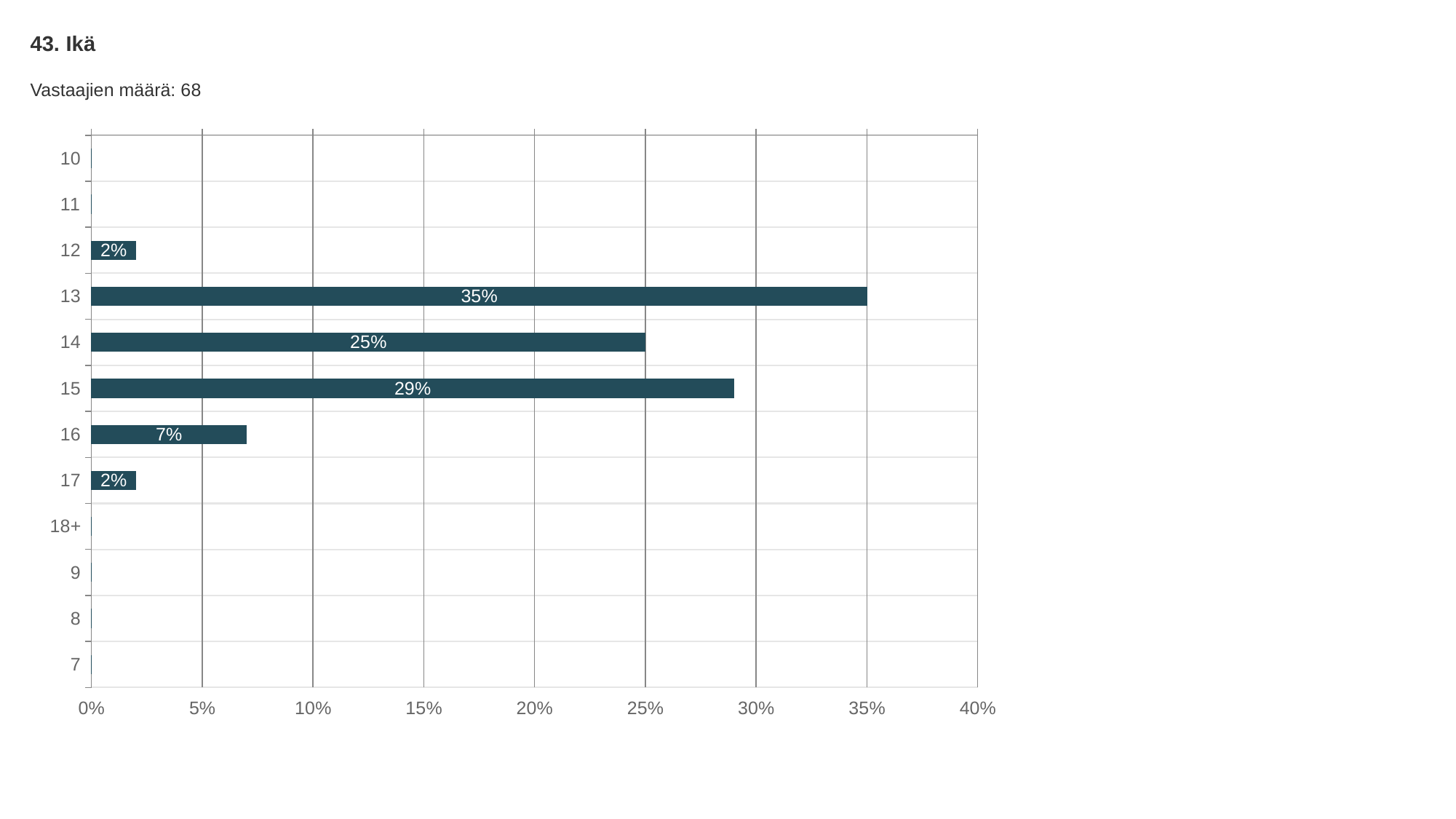
What is the title of the chart? 43. Ikä How many respondents (Vastaajien määrä) are stated on the slide? 68 What is the value for age 13? 35% What is the difference between the values for age 15 and age 16? 22% What is the value for age 16? 7% Which is larger, the value for age 14 or the value for age 15? 15 What is the difference between the values for age 13 and age 14? 10% What kind of chart is shown on the slide? bar chart Which age category has the highest value? 13 How many age categories are listed on the vertical axis? 12 Is the value for age 13 greater or less than 30%? greater What is the value for age 15? 29%